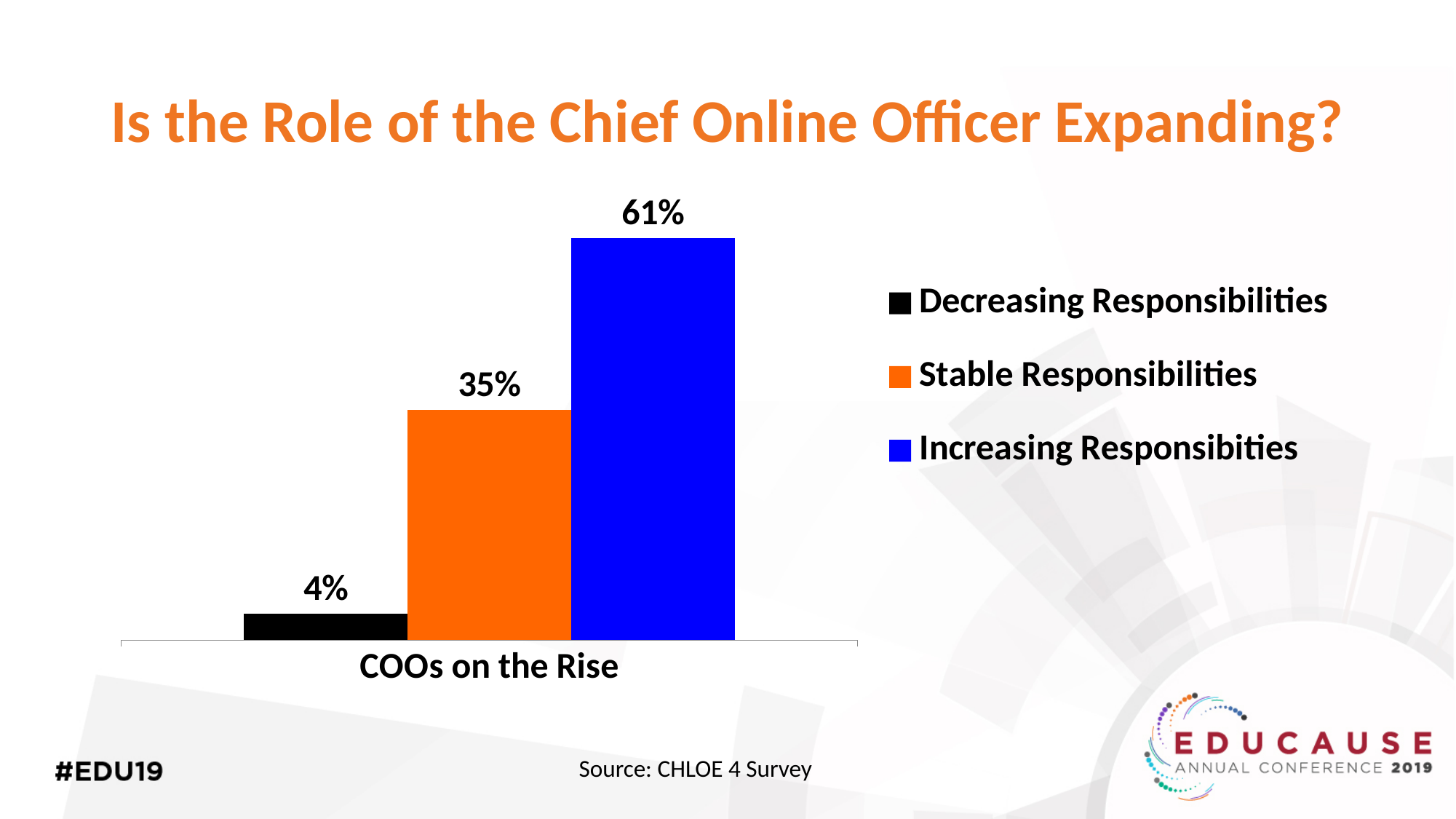
What colour is the bar for Stable Responsibilities? Orange What is the difference between the Stable Responsibilities value and the Decreasing Responsibilities value? 31% Which is larger, the value for Stable Responsibilities or the value for Decreasing Responsibilities? Stable Responsibilities How many series does the legend list? 3 Which series has the highest value? Increasing Responsibities What percentage is shown for Stable Responsibilities? 35% What percentage is shown for Increasing Responsibities? 61% What is the difference between the Increasing Responsibities value and the Stable Responsibilities value? 26% Which series has the lowest value? Decreasing Responsibilities What percentage is shown for Decreasing Responsibilities? 4% What is the category label shown on the x axis? COOs on the Rise What kind of chart is shown on the slide? Bar chart